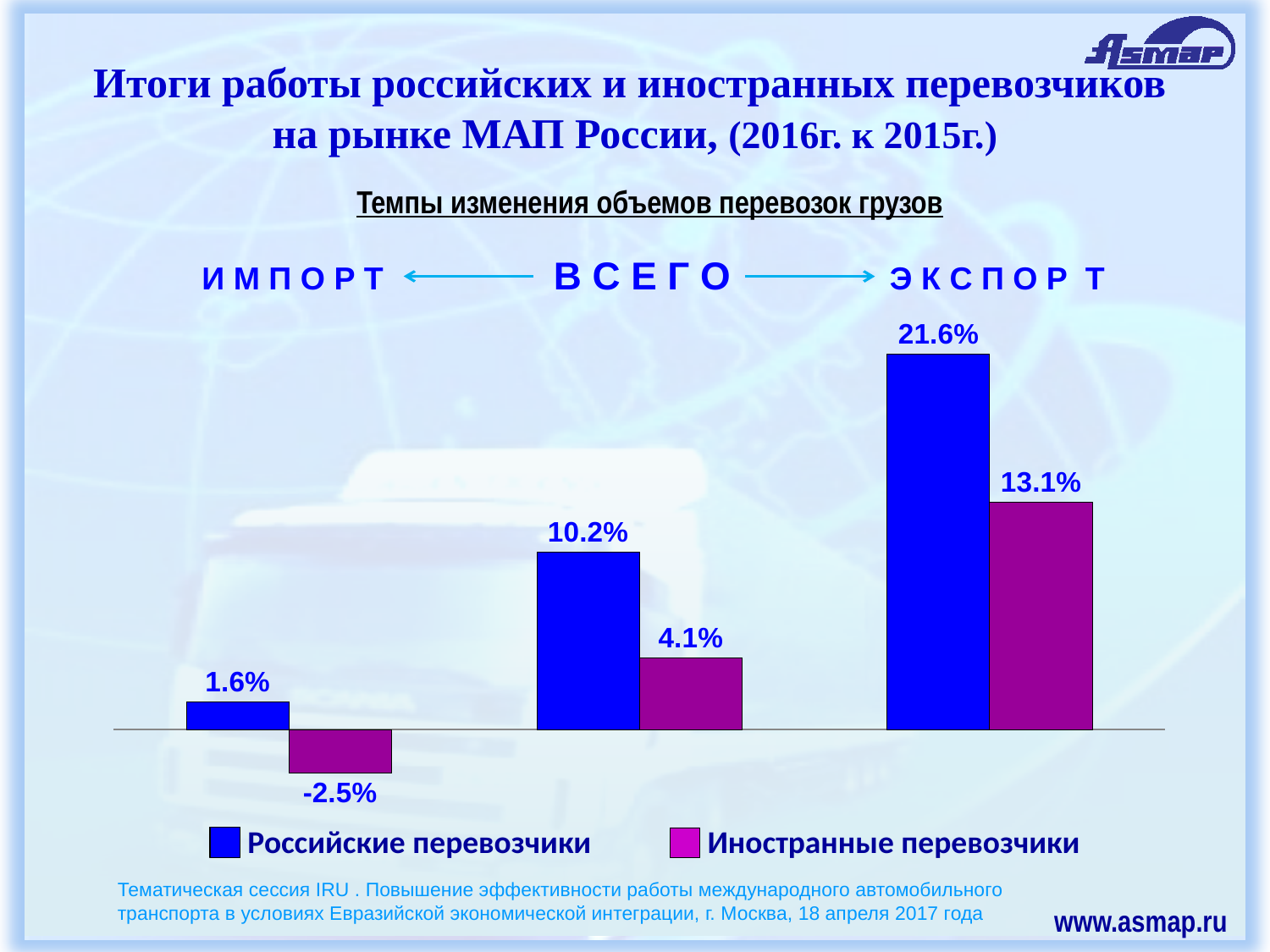
What is the value for Иностранные перевозчики in the ИМПОРТ category? -2.5% What is the value for Российские перевозчики in the ИМПОРТ category? 1.6% Which is larger in the ВСЕГО category: Российские перевозчики or Иностранные перевозчики? Российские перевозчики In which category is the value for Российские перевозчики highest? ЭКСПОРТ In which category is the value for Иностранные перевозчики lowest? ИМПОРТ What is the value for Российские перевозчики in the ВСЕГО category? 10.2% Which colour represents Иностранные перевозчики in the chart? Purple What kind of chart is shown on the slide? Bar chart What is the value for Иностранные перевозчики in the ЭКСПОРТ category? 13.1% What is the difference between the Российские перевозчики and Иностранные перевозчики values in the ЭКСПОРТ category? 8.5% How many categories are shown on the chart? 3 How many series does the legend list? 2